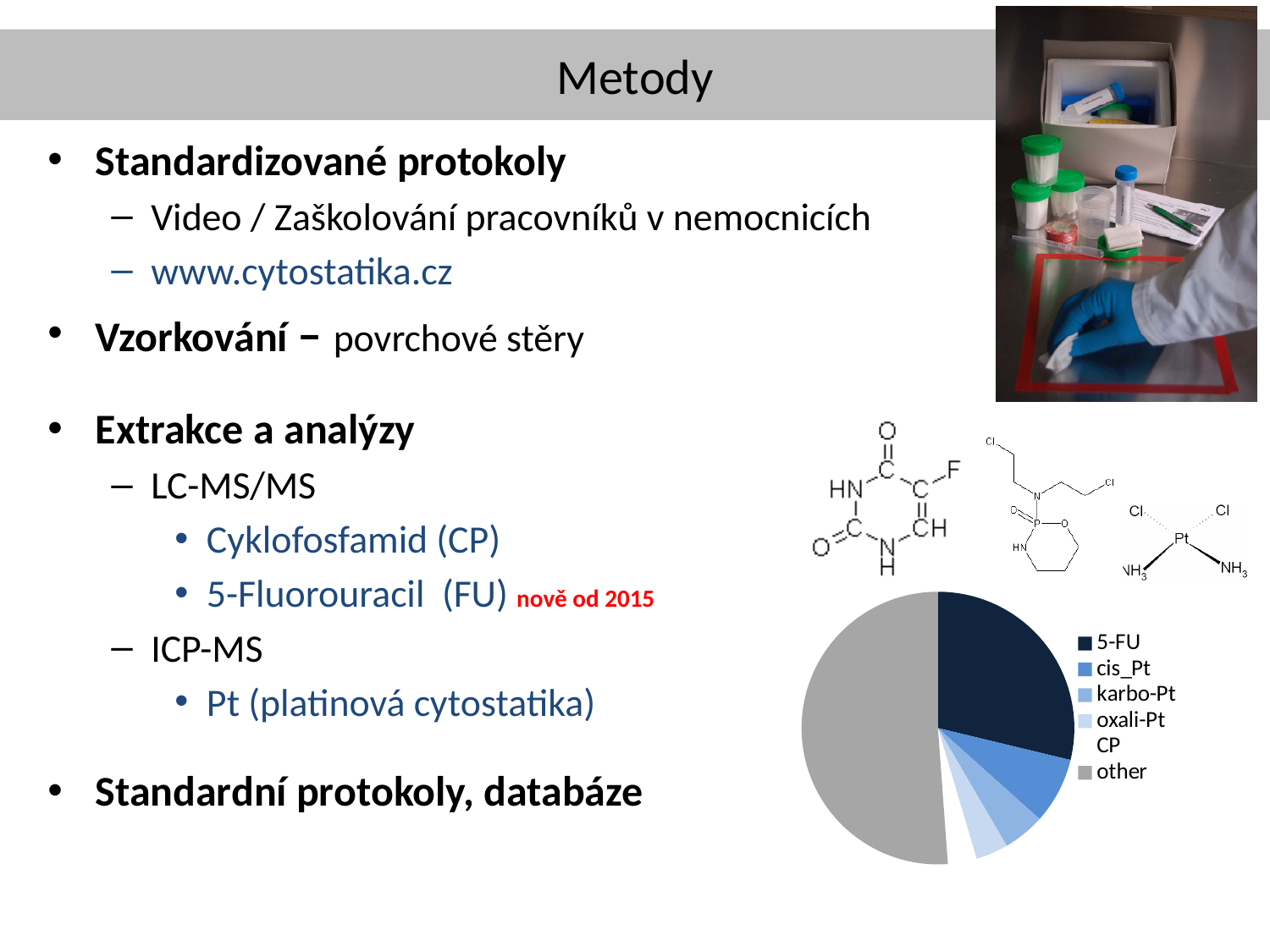
In the pie chart, which slice is larger, 5-FU or cis_Pt? 5-FU What colour is the 'other' slice in the pie chart? grey What kind of chart is shown at the bottom right of the slide? pie chart In the pie chart, which slice is larger, cis_Pt or karbo-Pt? cis_Pt Which legend entry of the pie chart is shown in dark navy blue? 5-FU How many categories does the legend of the pie chart list? 6 Which category has the largest slice in the pie chart? other In the pie chart, which slice is larger, 5-FU or karbo-Pt? 5-FU